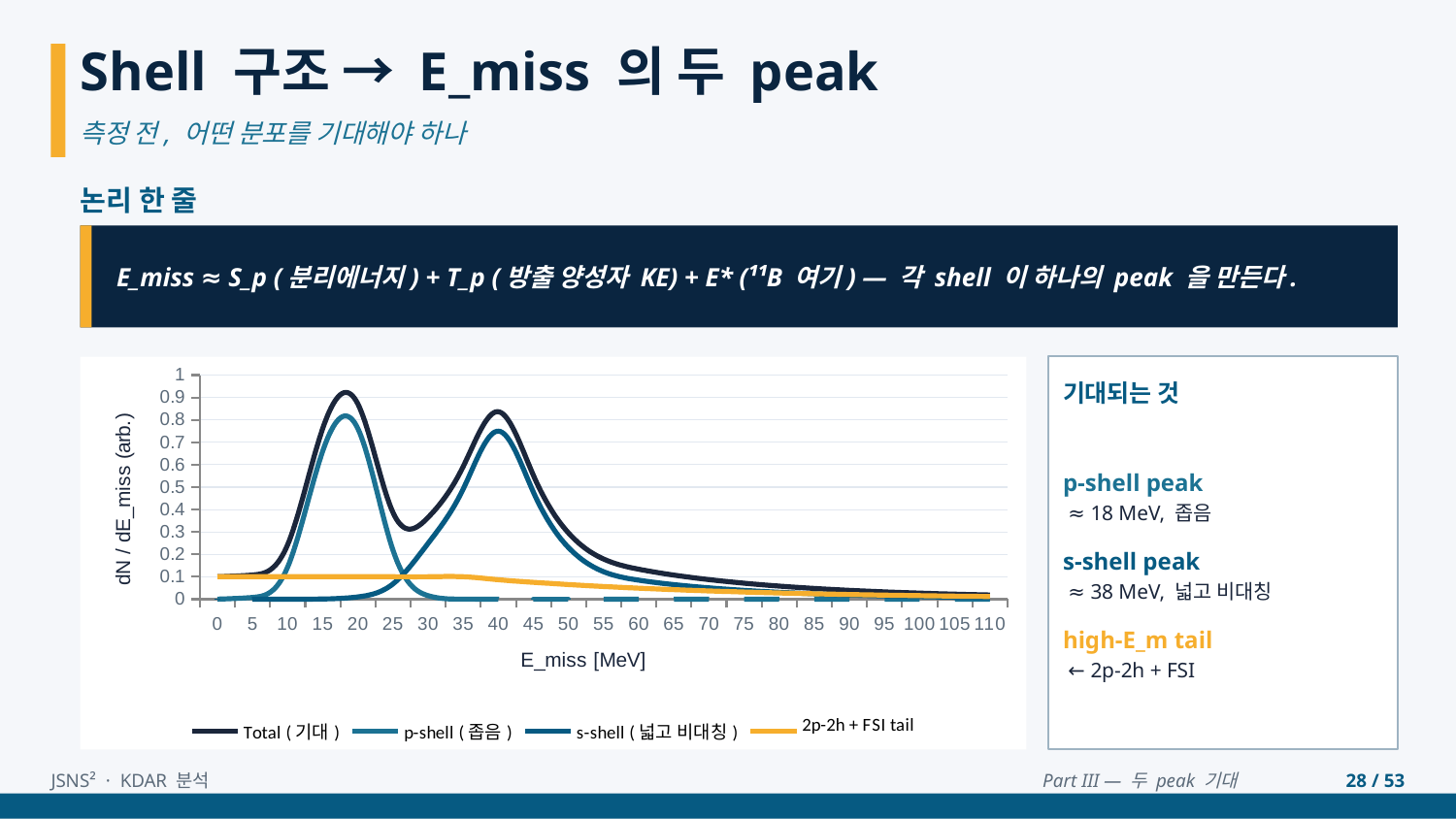
Which curve reaches a higher peak, p-shell ( 좁음 ) or s-shell ( 넓고 비대칭 )? p-shell ( 좁음 ) How many series does the chart legend list? 4 What kind of chart is shown on the slide? line chart What is the title of the x axis of the chart? E_miss [MeV] What is the highest value labelled on the y axis of the chart? 1 Is the value of the s-shell ( 넓고 비대칭 ) curve at 40 MeV greater or less than 0.5? greater Is the value of the 2p-2h + FSI tail curve at 0 MeV greater or less than 0.2? less Which of the two peaks of the Total ( 기대 ) curve is higher, the one near 18 MeV or the one near 40 MeV? the one near 18 MeV Is the value of the Total ( 기대 ) curve at 20 MeV greater or less than 0.5? greater Does the Total ( 기대 ) curve rise or fall as E_miss increases from 45 MeV to 110 MeV? fall Which legend entry is drawn in orange? 2p-2h + FSI tail